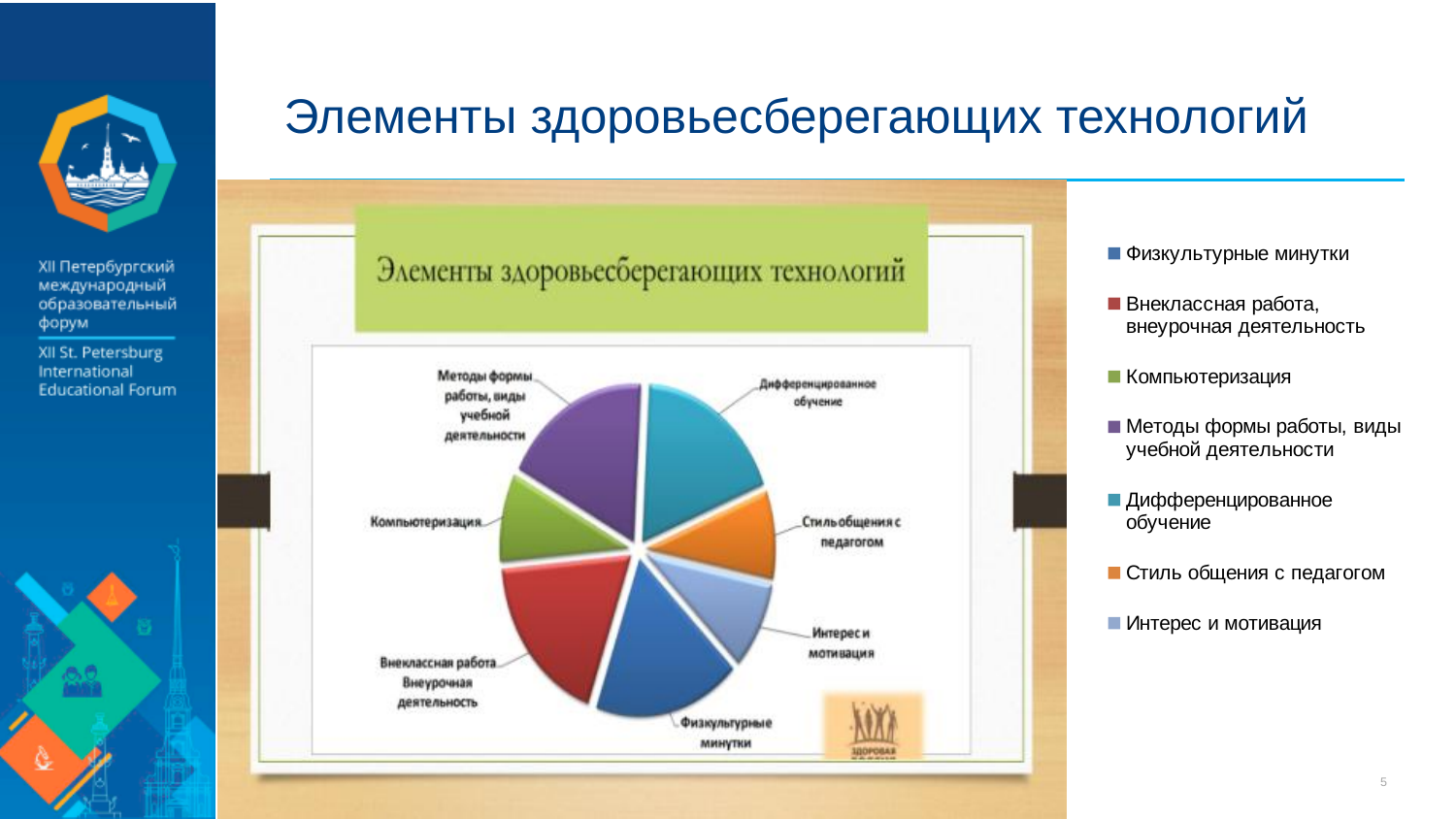
What kind of chart is shown on the slide? pie chart How many slices does the pie chart have? 7 Which slice is larger: "Методы формы работы, виды учебной деятельности" or "Стиль общения с педагогом"? Методы формы работы, виды учебной деятельности Which slice is larger: "Дифференцированное обучение" or "Интерес и мотивация"? Дифференцированное обучение Which colour represents "Компьютеризация" in the pie chart? green How many entries does the legend on the right of the slide list? 7 Which slice is larger: "Внеклассная работа, внеурочная деятельность" or "Стиль общения с педагогом"? Внеклассная работа, внеурочная деятельность What is the title of the pie chart? Элементы здоровьесберегающих технологий